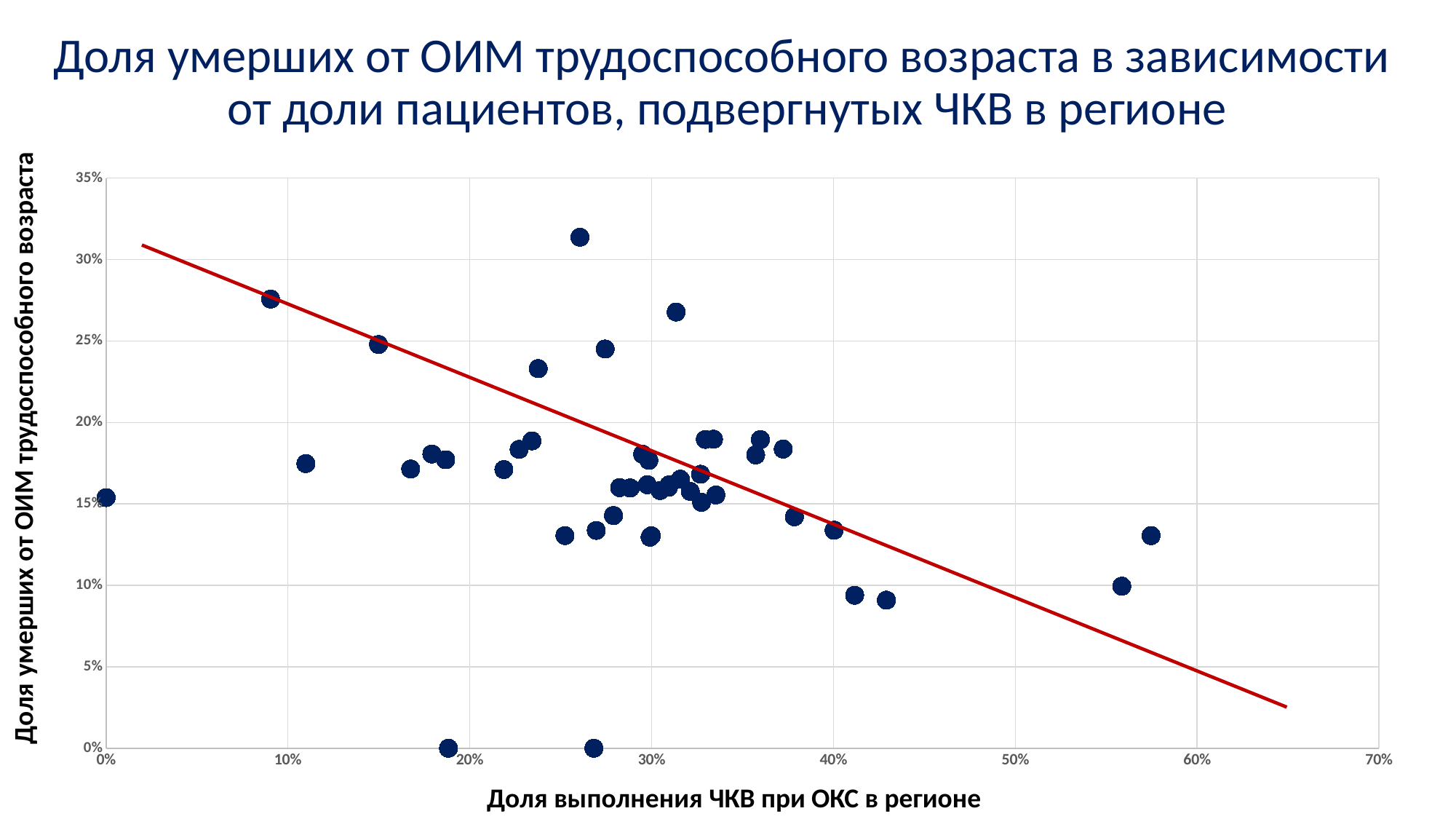
Between the highest point (around 26% on the x axis) and the point at about 9% on the x axis, which has the larger y value? The point around 26% on the x axis What is the highest tick value shown on the x axis? 70% Is the y value of the point at about 9% on the x axis greater or less than 25%? greater What is the title of the x axis? Доля выполнения ЧКВ при ОКС в регионе Is the y value of the point at about 56% on the x axis greater or less than 15%? less What is the title of the y axis? Доля умерших от ОИМ трудоспособного возраста How many points lie on the 0% line of the y axis? 2 What is the highest tick value shown on the y axis? 35% What kind of chart is shown on the slide? Scatter chart Is the y value of the rightmost point on the chart greater or less than 15%? less Does the red trend line rise or fall as the share of PCI (ЧКВ) on the x axis increases? Falls